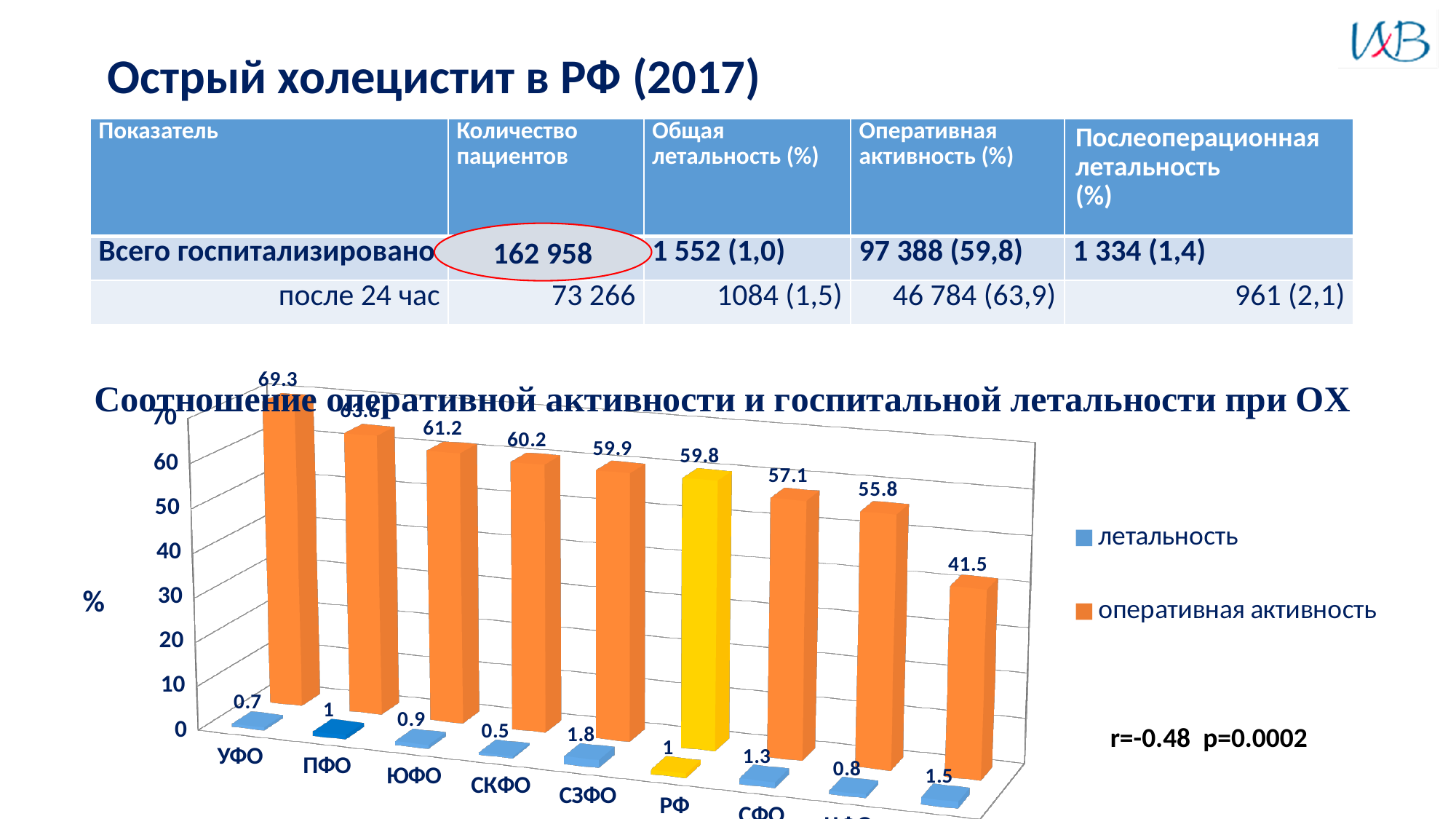
Which has the larger летальность value, СЗФО or СФО? СЗФО How many series does the chart legend list? 2 Which category has the highest летальность? СЗФО Is the оперативная активность value for СФО greater or less than 60? less What is the летальность value for СЗФО? 1.8 Which category has the lowest летальность? СКФО Which category has the highest оперативная активность? УФО What is the difference between the оперативная активность values for УФО and РФ? 9.5 What kind of chart is shown on the slide? bar chart What is the оперативная активность value for РФ? 59.8 Which series is shown in orange? оперативная активность What is the оперативная активность value for УФО? 69.3